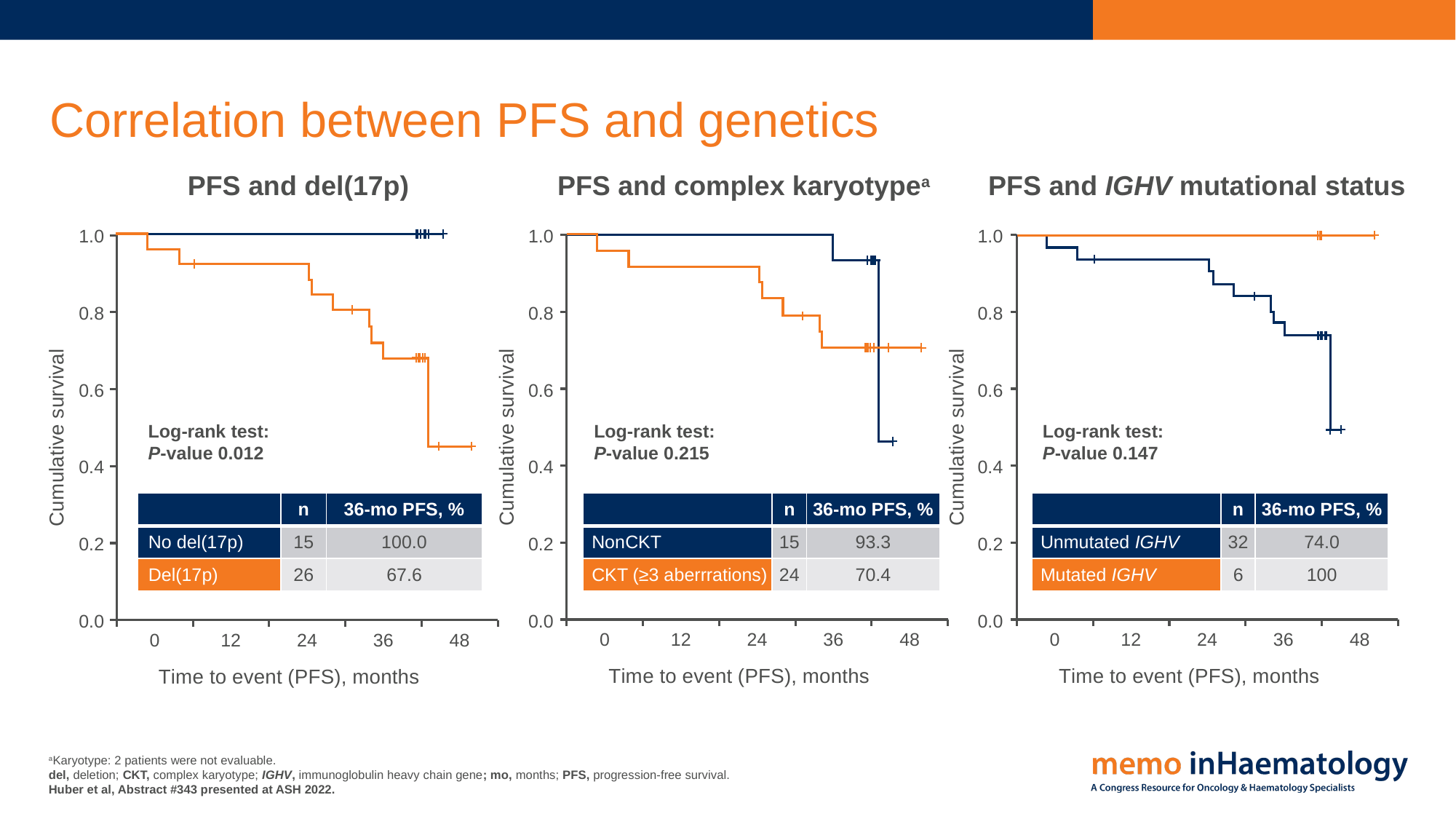
In the 'PFS and complex karyotype' chart, what is the 36-month PFS percentage for the CKT (≥3 aberrations) group? 70.4 What kind of chart is the 'PFS and del(17p)' chart? line chart In the 'PFS and del(17p)' chart, how many patients are in the Del(17p) group? 26 In the 'PFS and complex karyotype' chart, does the CKT (≥3 aberrations) curve rise or fall over time? fall In the 'PFS and del(17p)' chart, is the cumulative survival of the Del(17p) curve at 48 months greater or less than 0.6? less In the 'PFS and del(17p)' chart, what is the difference in 36-month PFS between the No del(17p) and Del(17p) groups? 32.4 What is the log-rank test P-value shown in the 'PFS and complex karyotype' chart? 0.215 In the 'PFS and del(17p)' chart, what is the 36-month PFS percentage for the No del(17p) group? 100.0 In the 'PFS and IGHV mutational status' chart, is the cumulative survival of the Mutated IGHV curve at 36 months greater or less than 0.8? greater In the 'PFS and IGHV mutational status' chart, which group has more patients, Unmutated IGHV or Mutated IGHV? Unmutated IGHV In the 'PFS and IGHV mutational status' chart, what is the 36-month PFS percentage for the Unmutated IGHV group? 74.0 In the 'PFS and complex karyotype' chart, which group has the higher 36-month PFS, NonCKT or CKT (≥3 aberrations)? NonCKT